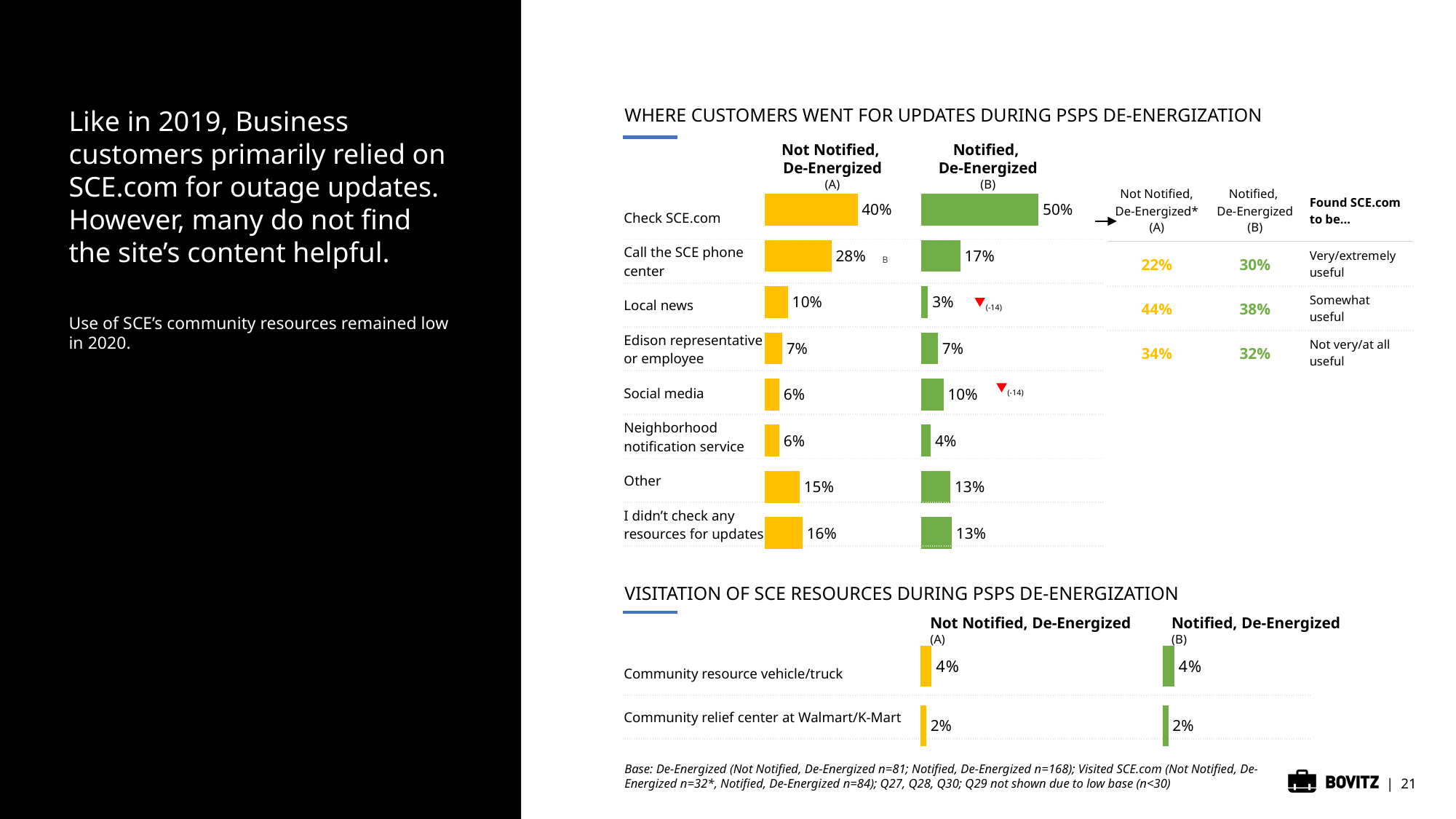
In the 'Where customers went for updates during PSPS de-energization' chart, what is the value for 'Call the SCE phone center' among Not Notified, De-Energized customers? 28% In the 'Where customers went for updates during PSPS de-energization' chart, which category has the highest value for Notified, De-Energized customers? Check SCE.com In the 'Visitation of SCE resources during PSPS de-energization' chart, what is the value for 'Community relief center at Walmart/K-Mart' among Notified, De-Energized customers? 2% In the 'Where customers went for updates during PSPS de-energization' chart, what percentage of Not Notified, De-Energized customers checked SCE.com? 40% How many categories are listed in the 'Where customers went for updates during PSPS de-energization' chart? 8 What kind of chart is used in the 'Visitation of SCE resources during PSPS de-energization' section? Bar chart In the 'Where customers went for updates during PSPS de-energization' chart, what percentage of Notified, De-Energized customers checked SCE.com? 50% In the 'Visitation of SCE resources during PSPS de-energization' chart, how many resources are listed? 2 In the 'Where customers went for updates during PSPS de-energization' chart, what is the difference between the Not Notified (28%) and Notified (17%) values for 'Call the SCE phone center'? 11 percentage points In the 'Where customers went for updates during PSPS de-energization' chart, which category has the lowest value for Notified, De-Energized customers? Local news In the 'Where customers went for updates during PSPS de-energization' chart, which group has the larger value for 'Social media': Not Notified, De-Energized or Notified, De-Energized? Notified, De-Energized In the 'Where customers went for updates during PSPS de-energization' chart, what colour are the bars for the Notified, De-Energized group? Green